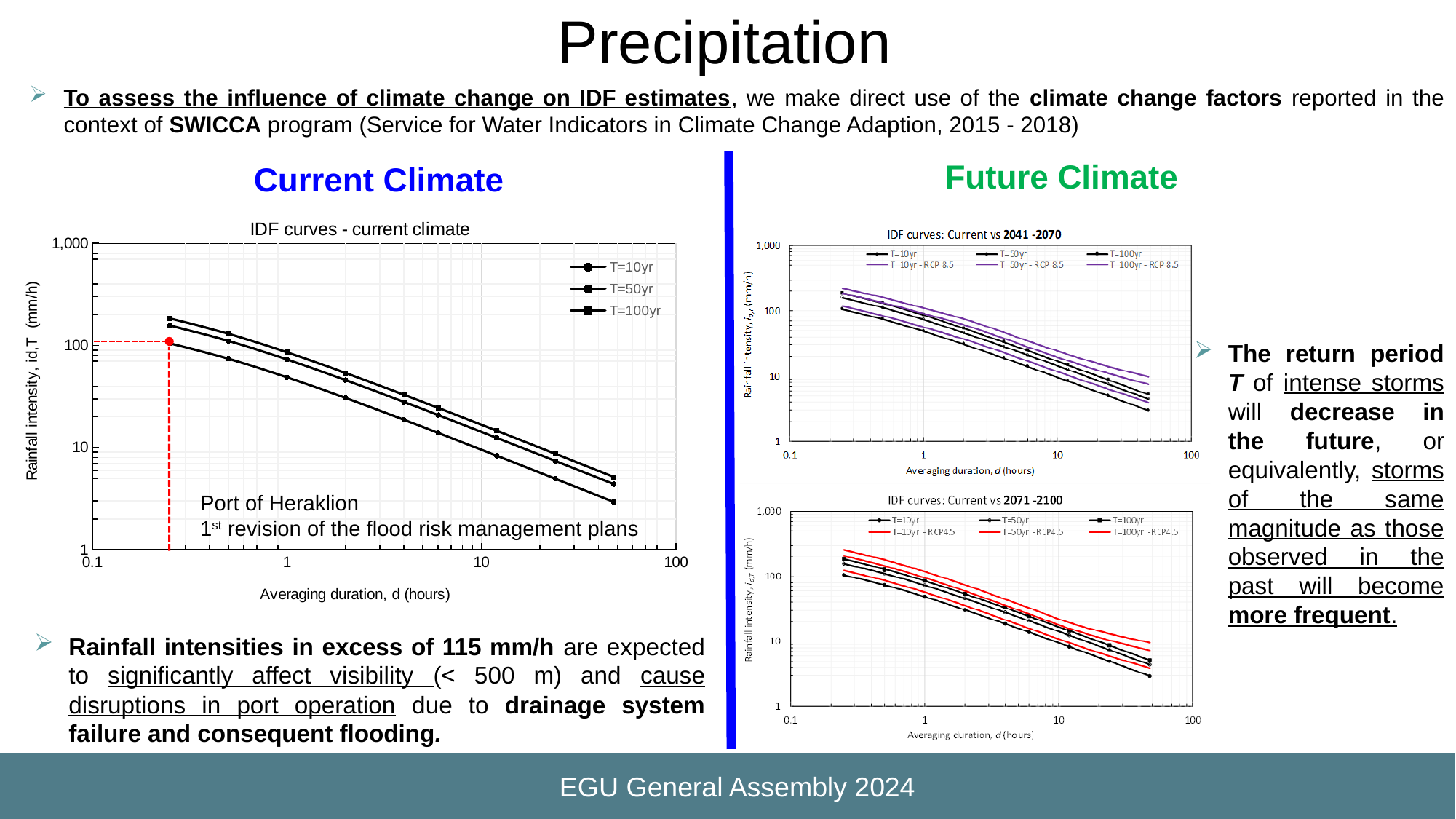
In the 'IDF curves - current climate' chart, is the T=10yr value at an averaging duration of 50 hours greater or less than 10 mm/h? less In the 'IDF curves - current climate' chart, which series has the lowest rainfall intensity values? T=10yr In the 'IDF curves - current climate' chart, do rainfall intensity values rise or fall as averaging duration increases? fall In the 'IDF curves: Current vs 2071 -2100' chart, at an averaging duration of 10 hours, which is larger, the T=100yr - RCP4.5 value or the T=10yr value? T=100yr - RCP4.5 In the 'IDF curves: Current vs 2071 -2100' chart, what colour are the RCP4.5 series lines? red In the 'IDF curves - current climate' chart, how many series does the legend list? 3 In the 'IDF curves - current climate' chart, what is the label of the x axis? Averaging duration, d (hours) In the 'IDF curves - current climate' chart, is the T=100yr value at an averaging duration of 0.25 hours greater or less than 100 mm/h? greater In the 'IDF curves - current climate' chart, at an averaging duration of 1 hour, which series has the larger value, T=50yr or T=10yr? T=50yr In the 'IDF curves - current climate' chart, what kind of chart is shown? line chart In the 'IDF curves - current climate' chart, which series has the highest rainfall intensity values? T=100yr In the 'IDF curves: Current vs 2041 -2070' chart, how many series does the legend list? 6